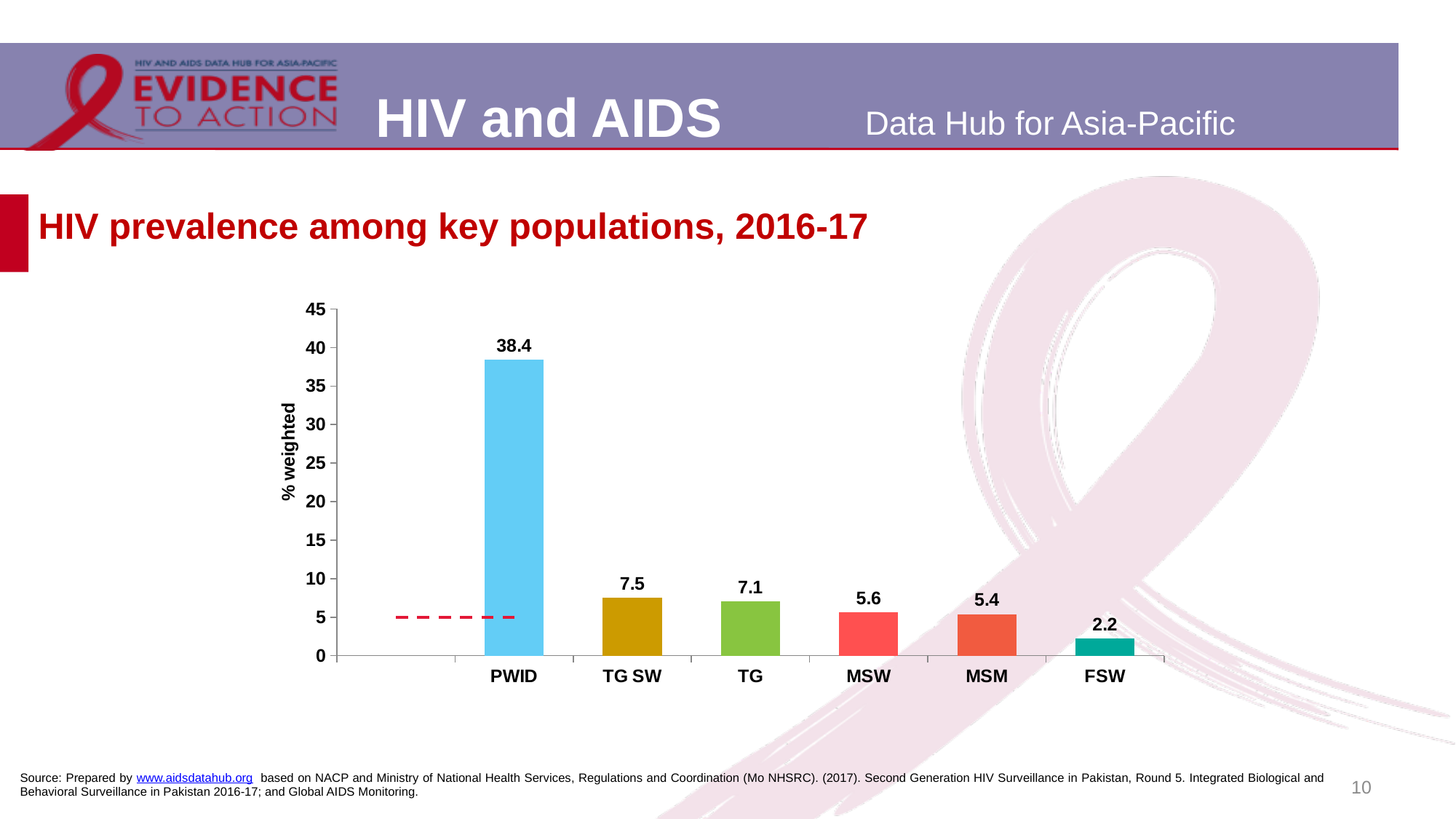
What is the difference between the values for TG and FSW? 4.9 What is the HIV prevalence value shown for PWID? 38.4 What is the value shown for FSW? 2.2 What is the value shown for TG SW? 7.5 What is the difference between the values for PWID and TG SW? 30.9 How many key populations are shown on the x axis? 6 Which key population has the highest HIV prevalence? PWID What kind of chart is shown on the slide? Bar chart Which key population has the lowest HIV prevalence? FSW What is the value shown for MSM? 5.4 Which has a higher value, MSW or MSM? MSW What is the label of the y axis? % weighted